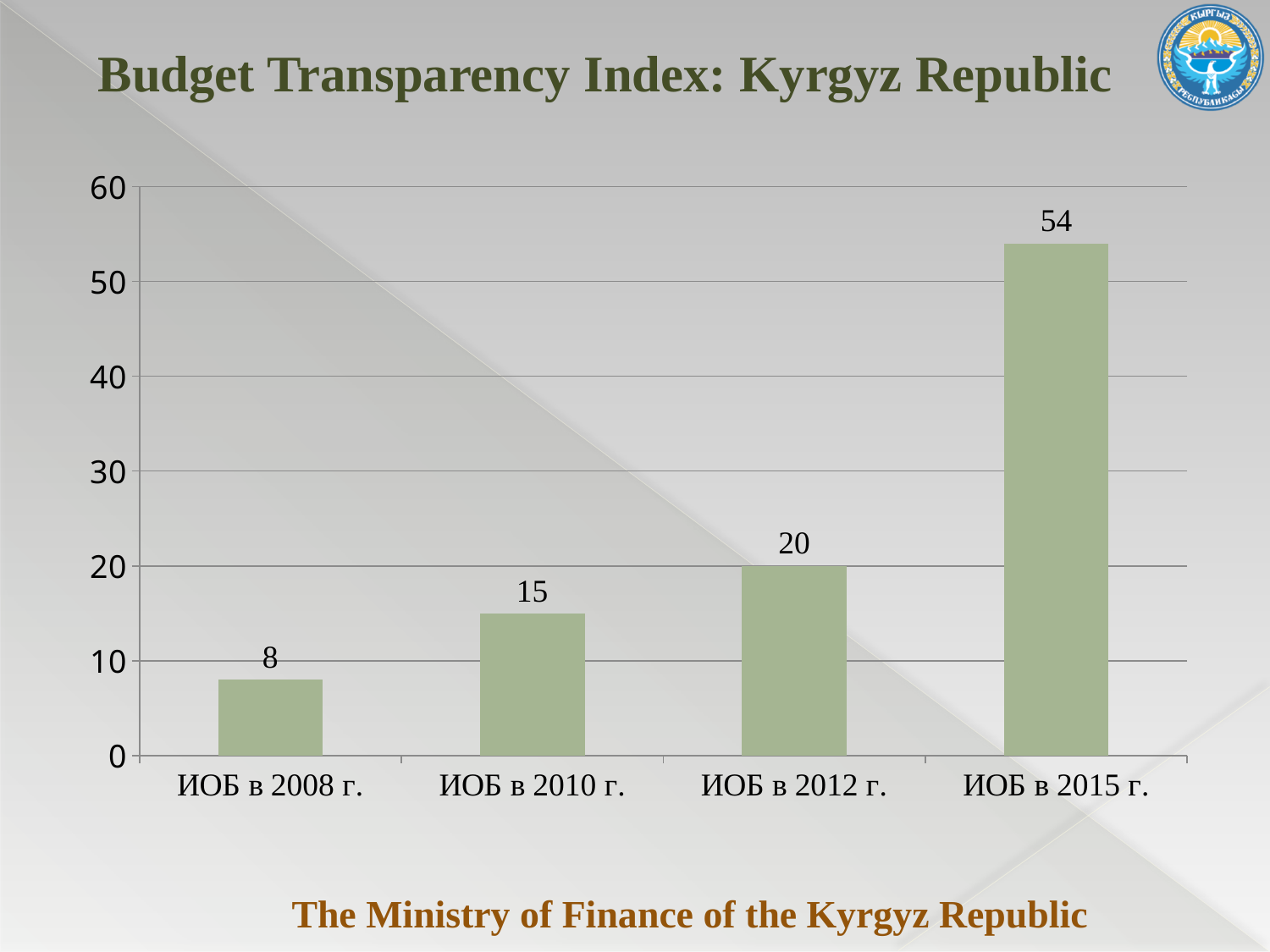
Do the values rise or fall from left to right along the x axis? rise What kind of chart is shown on the slide? bar chart Is the value for ИОБ в 2015 г. greater or less than 50? greater What is the value for ИОБ в 2015 г.? 54 What is the value for ИОБ в 2008 г.? 8 What is the difference between the values for ИОБ в 2015 г. and ИОБ в 2012 г.? 34 Which category has the lowest value? ИОБ в 2008 г. What is the value for ИОБ в 2010 г.? 15 Which is larger, the value for ИОБ в 2010 г. or ИОБ в 2012 г.? ИОБ в 2012 г. What is the value for ИОБ в 2012 г.? 20 How many categories are shown on the x axis? 4 Which category has the highest value? ИОБ в 2015 г.